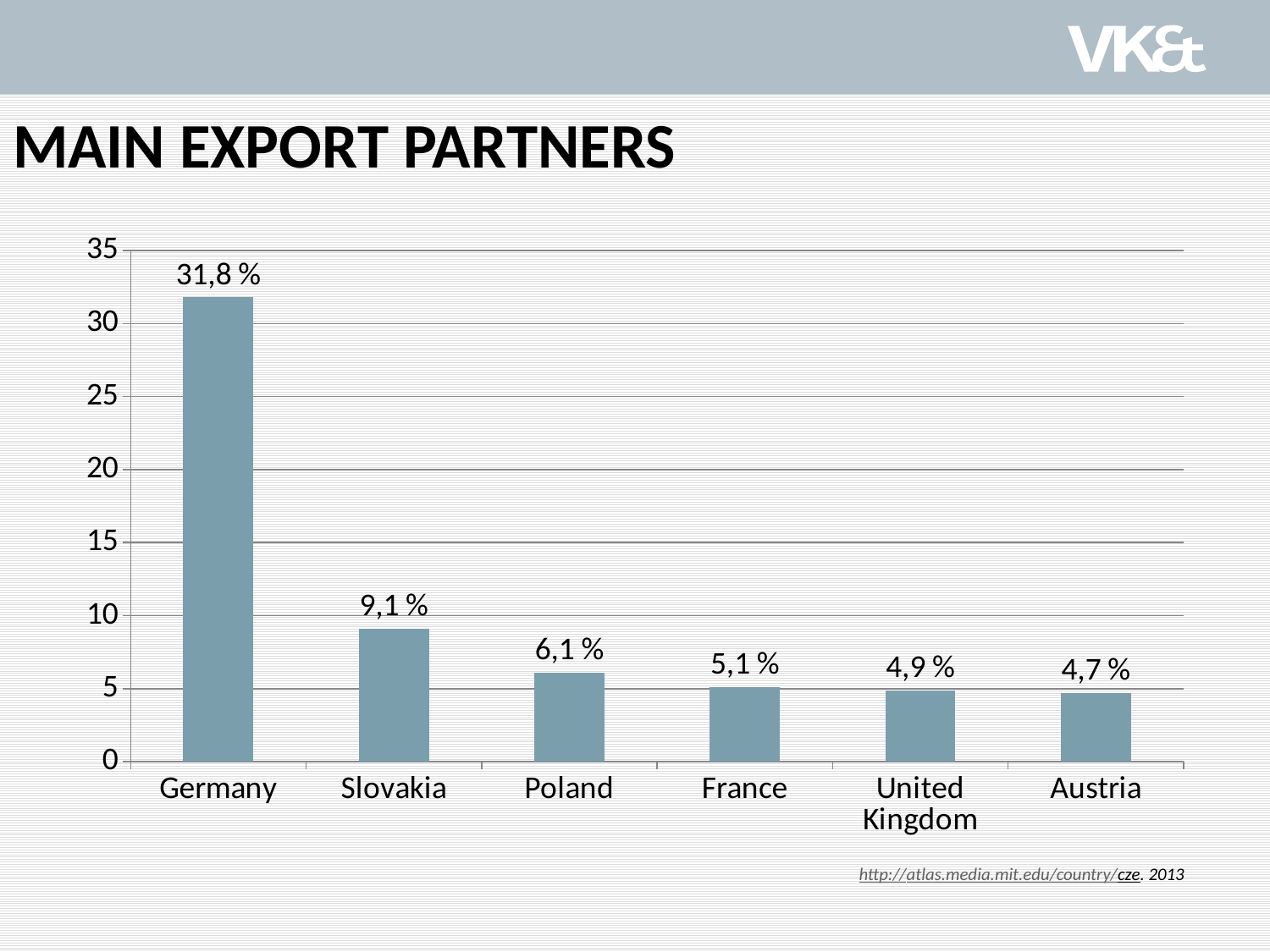
What is the difference between the values for Poland and France? 1,0 % What is the value for Germany? 31,8 % What is the value for United Kingdom? 4,9 % How many countries are shown on the chart? 6 What kind of chart is shown on the slide? bar chart Which country has the lowest value? Austria Which is larger, the value for Slovakia or the value for Poland? Slovakia What is the value for Slovakia? 9,1 % Do the values rise or fall from Germany to Austria along the x axis? fall Is the value for Germany greater or less than 30? greater Which country has the highest value? Germany What is the difference between the values for Germany and Slovakia? 22,7 %